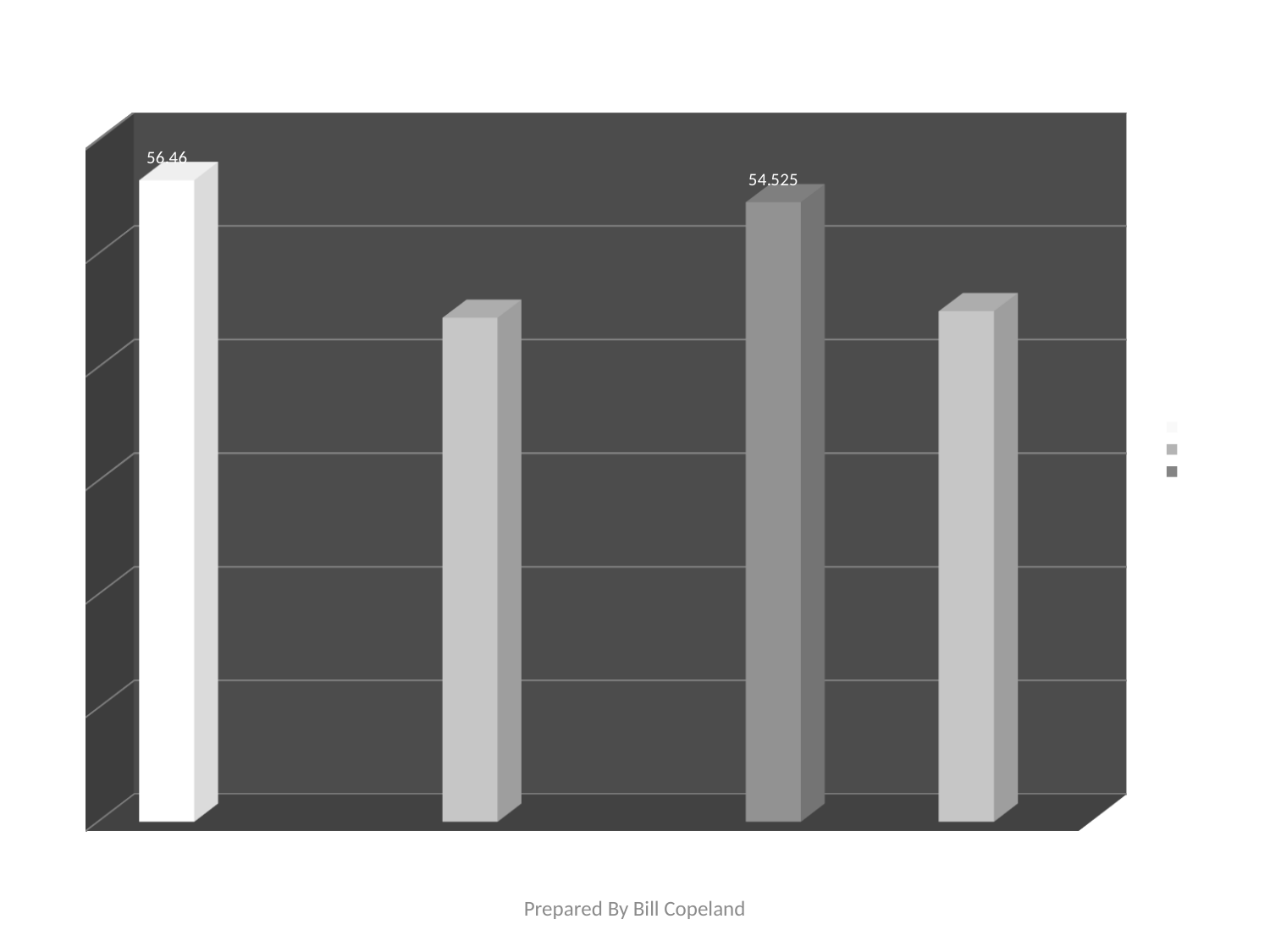
How many bars are plotted in the chart? 4 What colour is the tallest bar in the chart? white What text appears at the bottom of the slide below the chart? Prepared By Bill Copeland Which bar is the tallest in the chart? the leftmost (first) bar How many entries does the legend list? 3 What is the value labelled on the third bar from the left? 54.525 Which is larger, the value of the first bar or the value of the third bar? the first bar (56.46) What is the difference between the labelled values of the first bar (56.46) and the third bar (54.525)? 1.935 What is the value labelled on the leftmost (first) bar? 56.46 What kind of chart is shown on the slide? bar chart